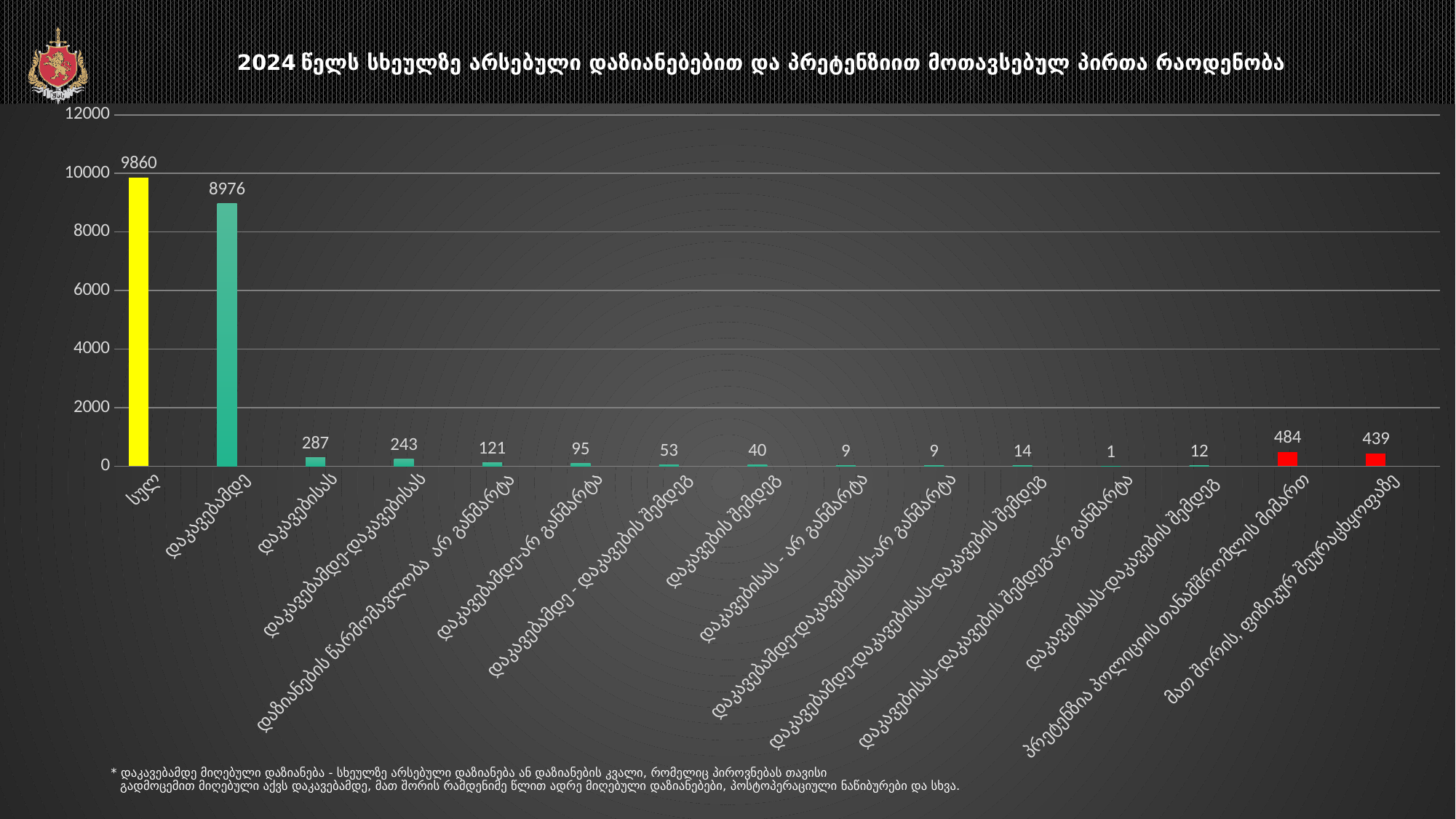
What kind of chart is shown on the slide? Bar chart What is the value for პრეტენზია პოლიციის თანამშრომლის მიმართ? 484 Which is larger, დაკავებისას or დაკავებამდე-დაკავებისას? დაკავებისას What is the difference between the values for სულ and დაკავებამდე? 884 How many bars are shown on the chart? 15 Which category has the highest value? სულ What is the value for დაკავებისას? 287 What is the value for დაკავებამდე? 8976 What is the difference between პრეტენზია პოლიციის თანამშრომლის მიმართ and მათ შორის, ფიზიკურ შეურაცხყოფაზე? 45 What is the value for სულ? 9860 What is the value for მათ შორის, ფიზიკურ შეურაცხყოფაზე? 439 What is the smallest value shown on the chart? 1